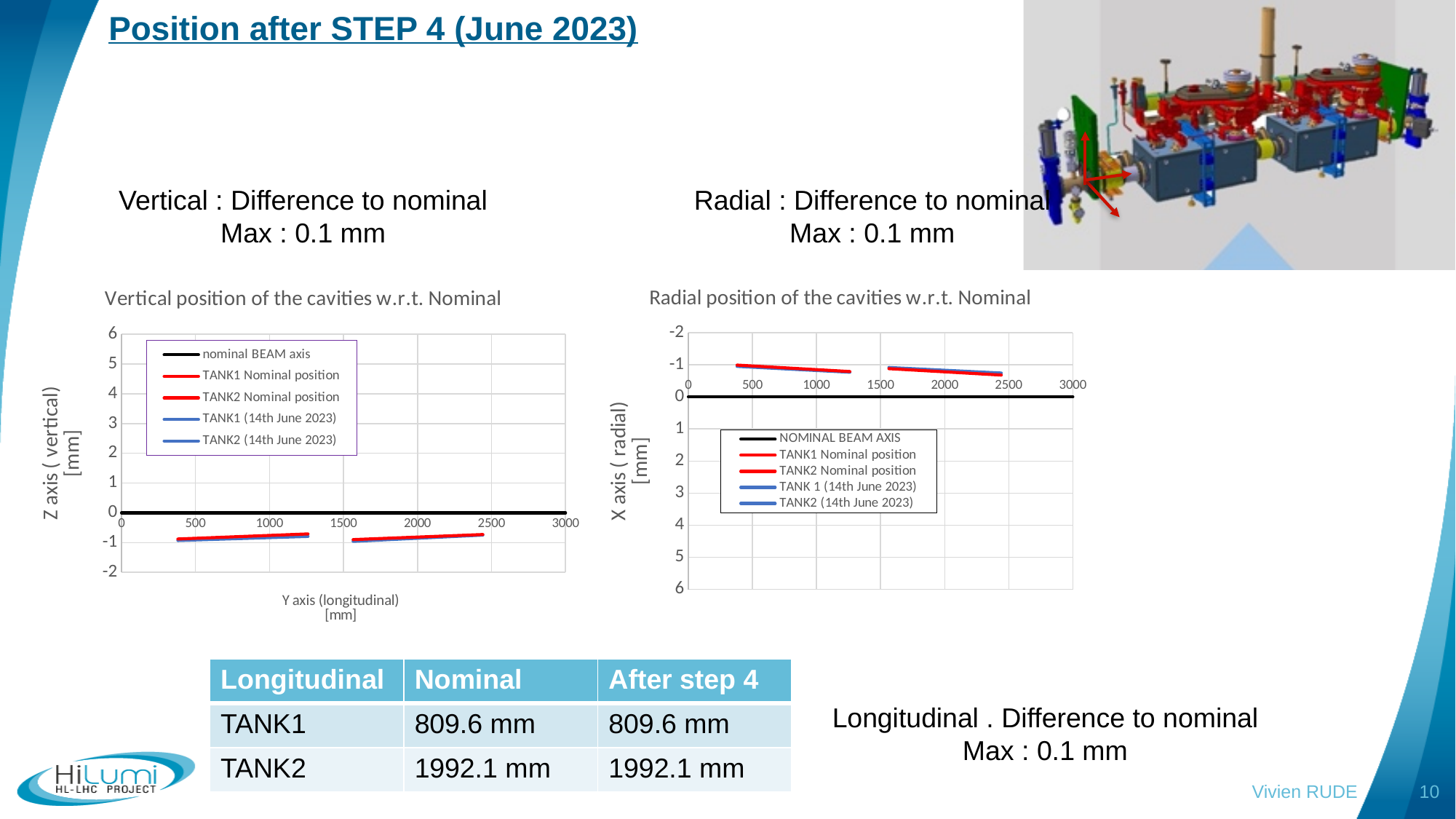
What is the label of the vertical axis of the 'Radial position of the cavities w.r.t. Nominal' chart? X axis ( radial) [mm] In the 'Vertical position of the cavities w.r.t. Nominal' chart, does the 'TANK1 Nominal position' line rise or fall as the longitudinal position increases? rise How many series does the legend of the 'Radial position of the cavities w.r.t. Nominal' chart list? 5 In the 'Radial position of the cavities w.r.t. Nominal' chart, are the values of the 'TANK2 Nominal position' line greater or less than 0? less In the 'Radial position of the cavities w.r.t. Nominal' chart, at what value on the vertical axis does the 'NOMINAL BEAM AXIS' line sit? 0 In the 'Vertical position of the cavities w.r.t. Nominal' chart, are the values of the 'TANK1 Nominal position' line greater or less than 0? less In the 'Vertical position of the cavities w.r.t. Nominal' chart, at what value on the vertical axis does the 'nominal BEAM axis' line sit? 0 In the 'Radial position of the cavities w.r.t. Nominal' chart, are the values of the 'TANK1 Nominal position' line greater or less than -2? greater What kind of chart is the 'Vertical position of the cavities w.r.t. Nominal' chart? line chart What is the label of the horizontal axis of the 'Vertical position of the cavities w.r.t. Nominal' chart? Y axis (longitudinal) [mm] How many series does the legend of the 'Vertical position of the cavities w.r.t. Nominal' chart list? 5